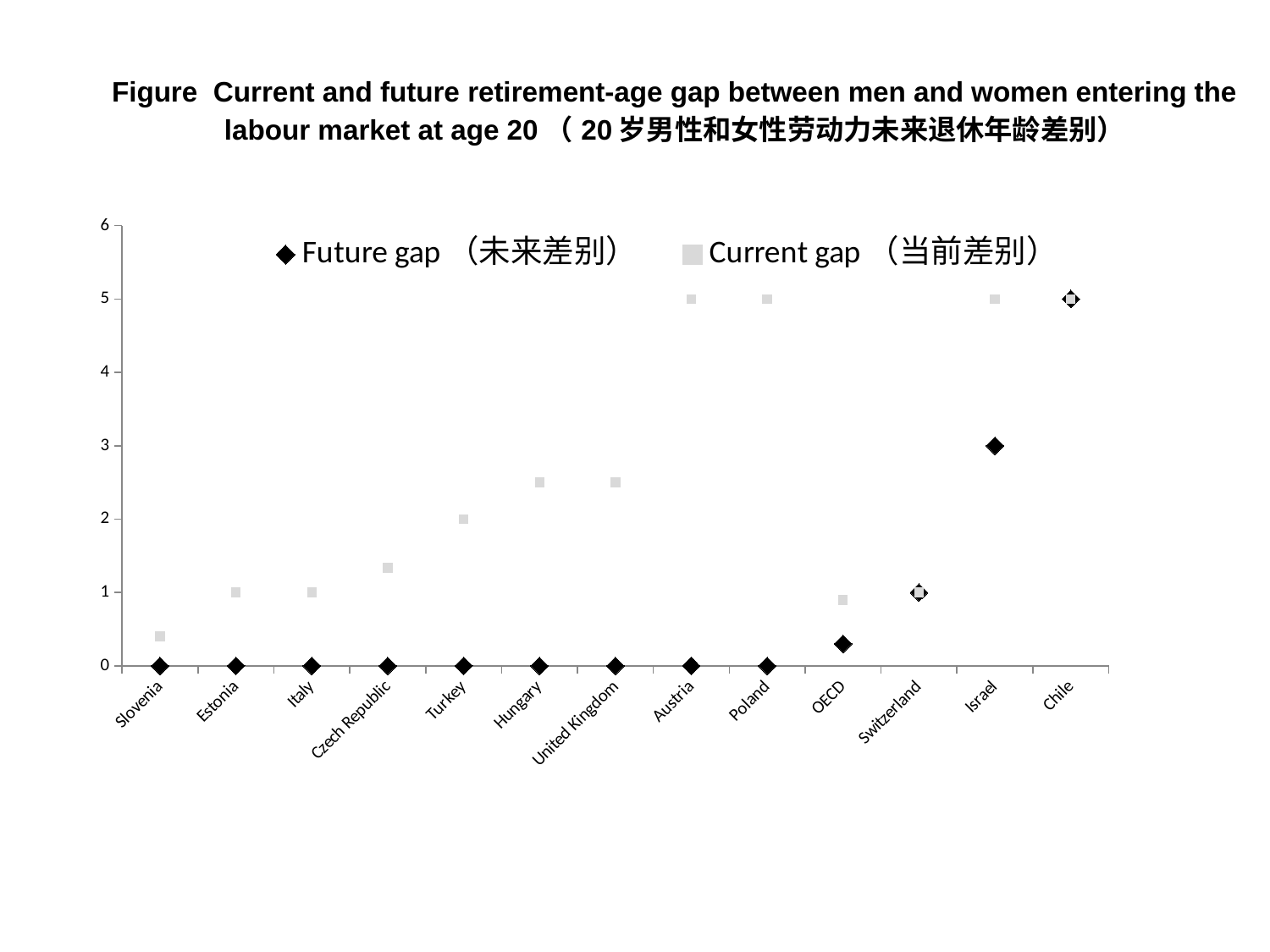
Which category has the highest Future gap value? Chile How many series does the legend list? 2 Which has the larger Future gap value, Israel or Switzerland? Israel What is the Future gap value for Israel? 3 What is the difference between the Current gap and the Future gap for Israel? 2 What is the Current gap value for Estonia? 1 What is the Current gap value for Turkey? 2 What is the Future gap value for Chile? 5 Is the Current gap value for Hungary greater or less than 2? greater What kind of chart is shown on the slide? scatter chart How many countries/categories are plotted along the x axis? 13 Which category has the lowest Current gap value? Slovenia